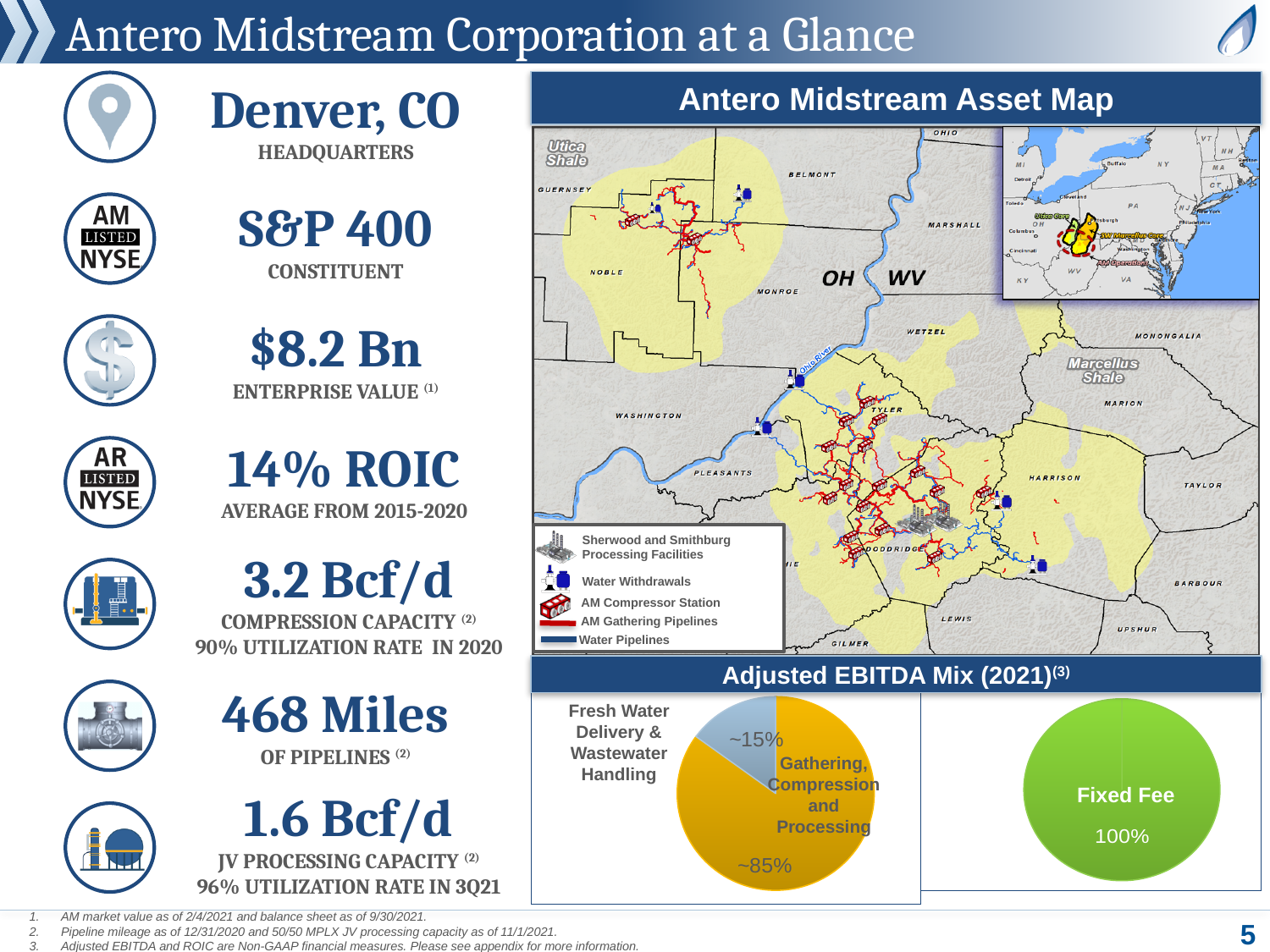
In the left Adjusted EBITDA Mix (2021) pie chart, what share is labelled for Gathering, Compression and Processing? ~85% What kind of chart is used for the Adjusted EBITDA Mix (2021) on the left? Pie chart How many slices does the right Adjusted EBITDA Mix (2021) pie chart have? 1 In the right Adjusted EBITDA Mix (2021) pie chart, what share is labelled for Fixed Fee? 100% What is the title of the section containing the two pie charts? Adjusted EBITDA Mix (2021) In the left Adjusted EBITDA Mix (2021) pie chart, which is larger: Gathering, Compression and Processing or Fresh Water Delivery & Wastewater Handling? Gathering, Compression and Processing In the left Adjusted EBITDA Mix (2021) pie chart, what share is labelled for Fresh Water Delivery & Wastewater Handling? ~15% How many slices does the left Adjusted EBITDA Mix (2021) pie chart have? 2 What colour is the Fixed Fee slice in the right Adjusted EBITDA Mix (2021) pie chart? Green In the left Adjusted EBITDA Mix (2021) pie chart, which slice is the smallest? Fresh Water Delivery & Wastewater Handling In the left Adjusted EBITDA Mix (2021) pie chart, which slice is the largest? Gathering, Compression and Processing